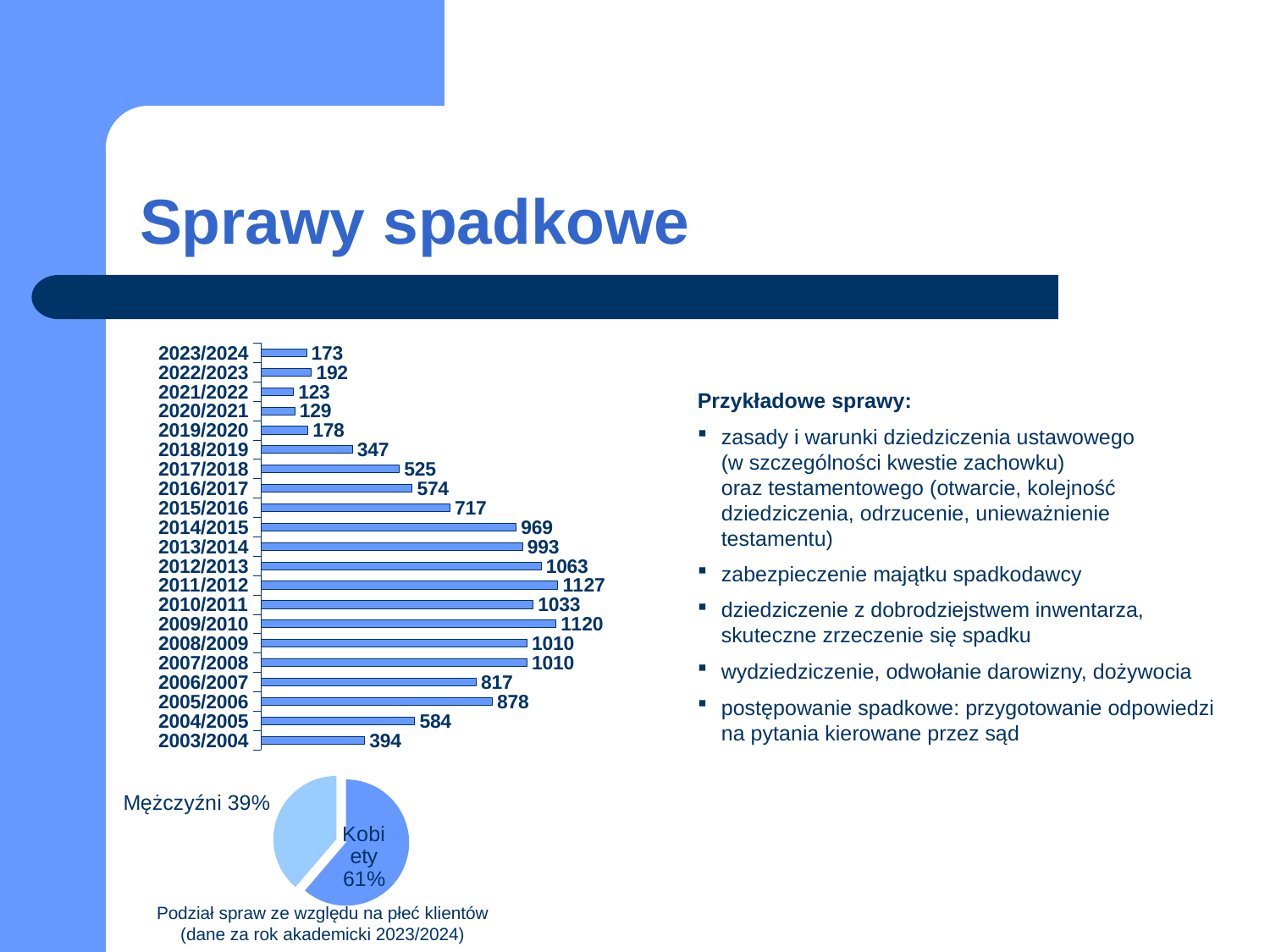
In the bar chart, which academic year has the highest value? 2011/2012 In the bar chart, which is larger: the value for 2005/2006 or the value for 2006/2007? 2005/2006 In the pie chart 'Podział spraw ze względu na płeć klientów', what share is Kobiety? 61% In the bar chart, which academic year has the lowest value? 2021/2022 In the bar chart, what is the value for 2023/2024? 173 In the bar chart, what is the value for 2003/2004? 394 In the bar chart, what is the difference between the values for 2015/2016 and 2016/2017? 143 What kind of chart is 'Podział spraw ze względu na płeć klientów'? pie chart What kind of chart shows the values by academic year? bar chart In the bar chart, what is the value for 2011/2012? 1127 How many academic years are shown in the bar chart? 21 In the pie chart 'Podział spraw ze względu na płeć klientów', what share is Mężczyźni? 39%